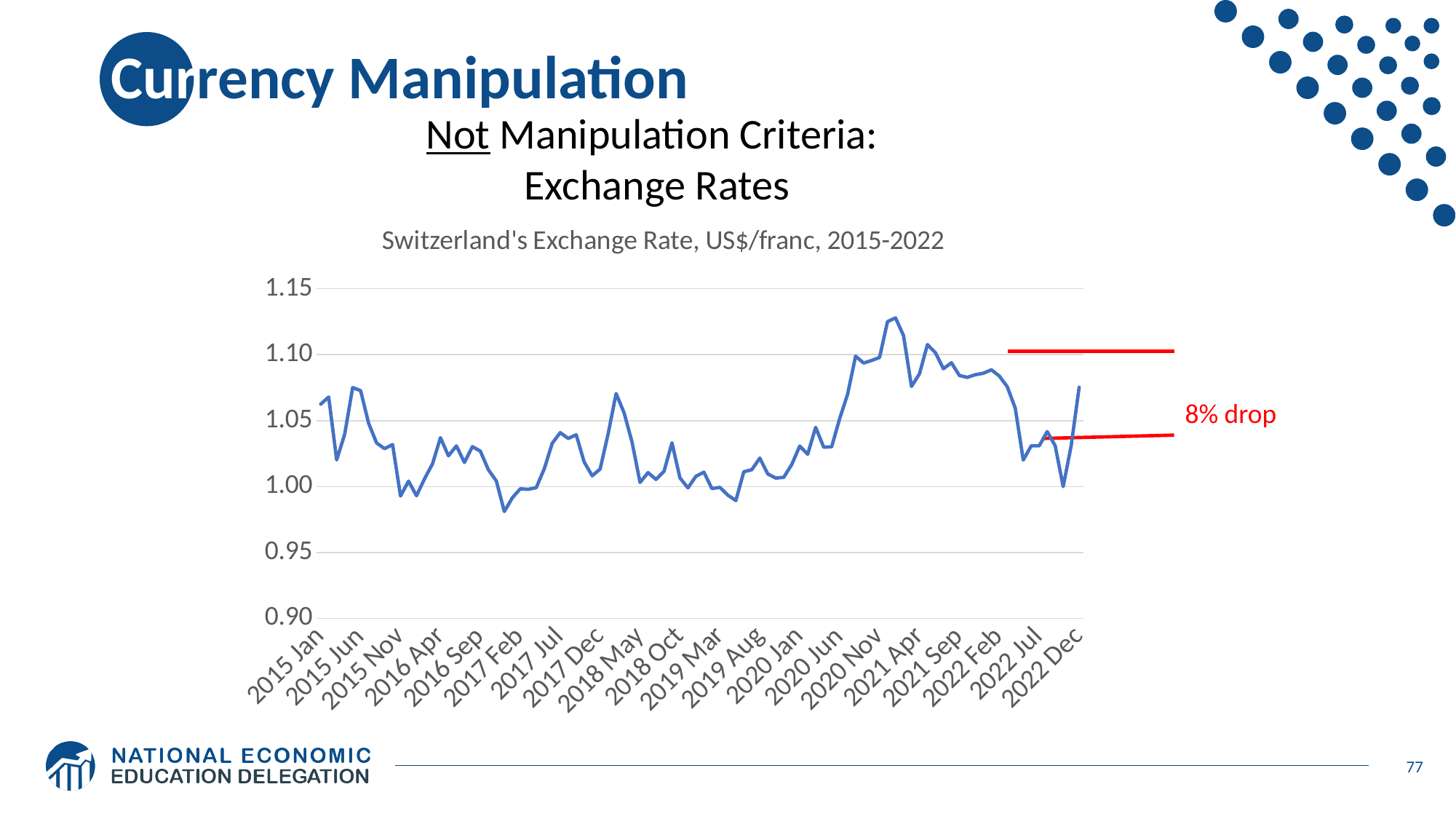
What annotation is written in red next to the chart? 8% drop Which of 2015 Jan and 2017 Feb has the higher value? 2015 Jan How many month labels are shown on the x axis? 20 What kind of chart is shown on the slide? Line chart What is the title of the chart? Switzerland's Exchange Rate, US$/franc, 2015-2022 Is the value for 2022 Dec greater or less than 1.05? greater Is the value for 2019 Mar greater or less than 1.05? less Does the line rise or fall between 2019 Aug and 2020 Nov? rise Is the value for 2021 Apr greater or less than 1.05? greater Does the line rise or fall between 2022 Feb and 2022 Jul? fall